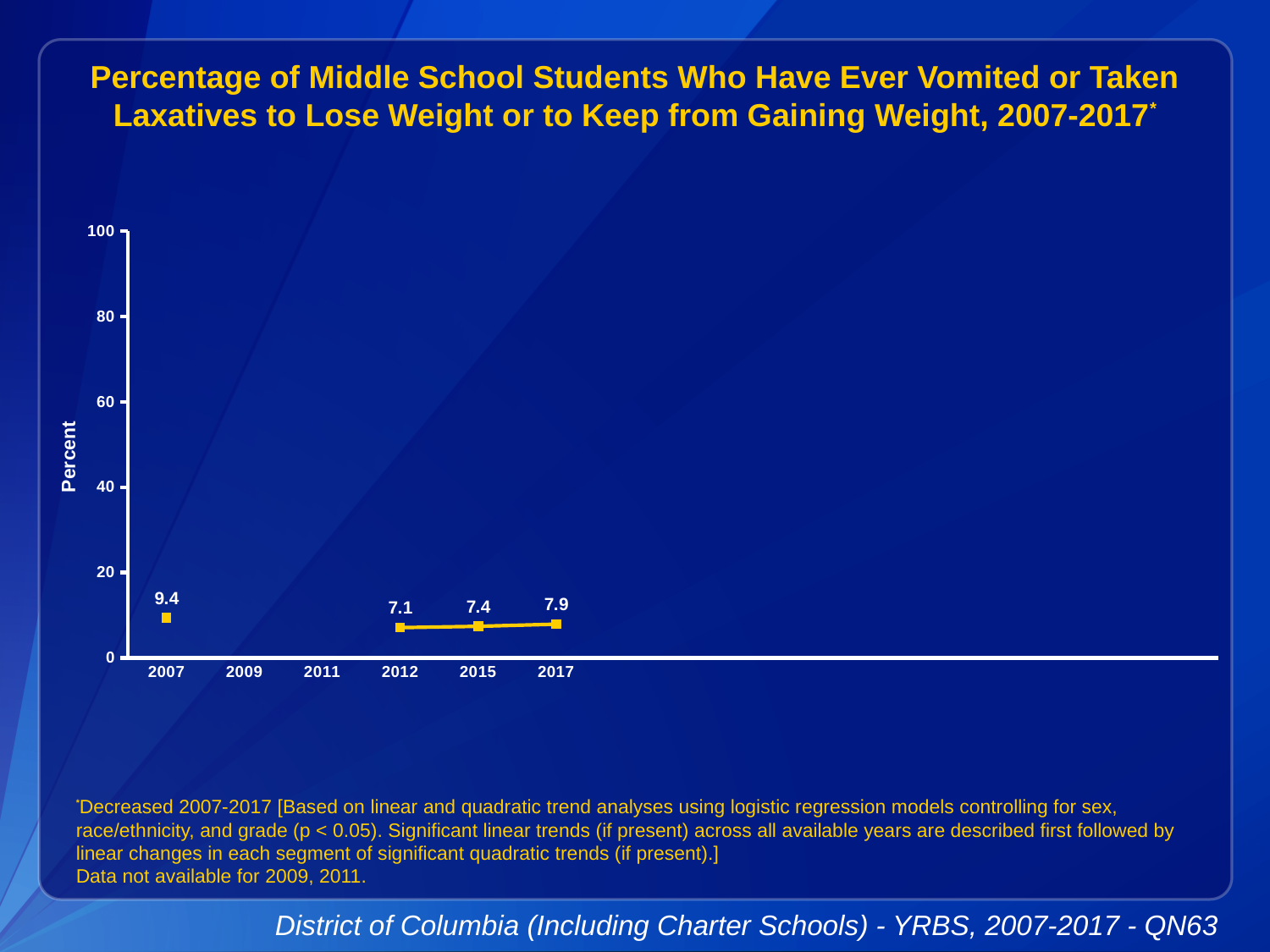
How many years have data points plotted on the chart? 4 What is the value for 2017? 7.9 Is the value for 2007 greater or less than 20? less What is the label on the y axis? Percent What is the difference between the values for 2007 and 2017? 1.5 What is the value for 2007? 9.4 What kind of chart is shown on the slide? line chart Which is larger, the value for 2015 or the value for 2017? 2017 Which year has the lowest value? 2012 What is the value for 2015? 7.4 What is the value for 2012? 7.1 Which year has the highest value? 2007